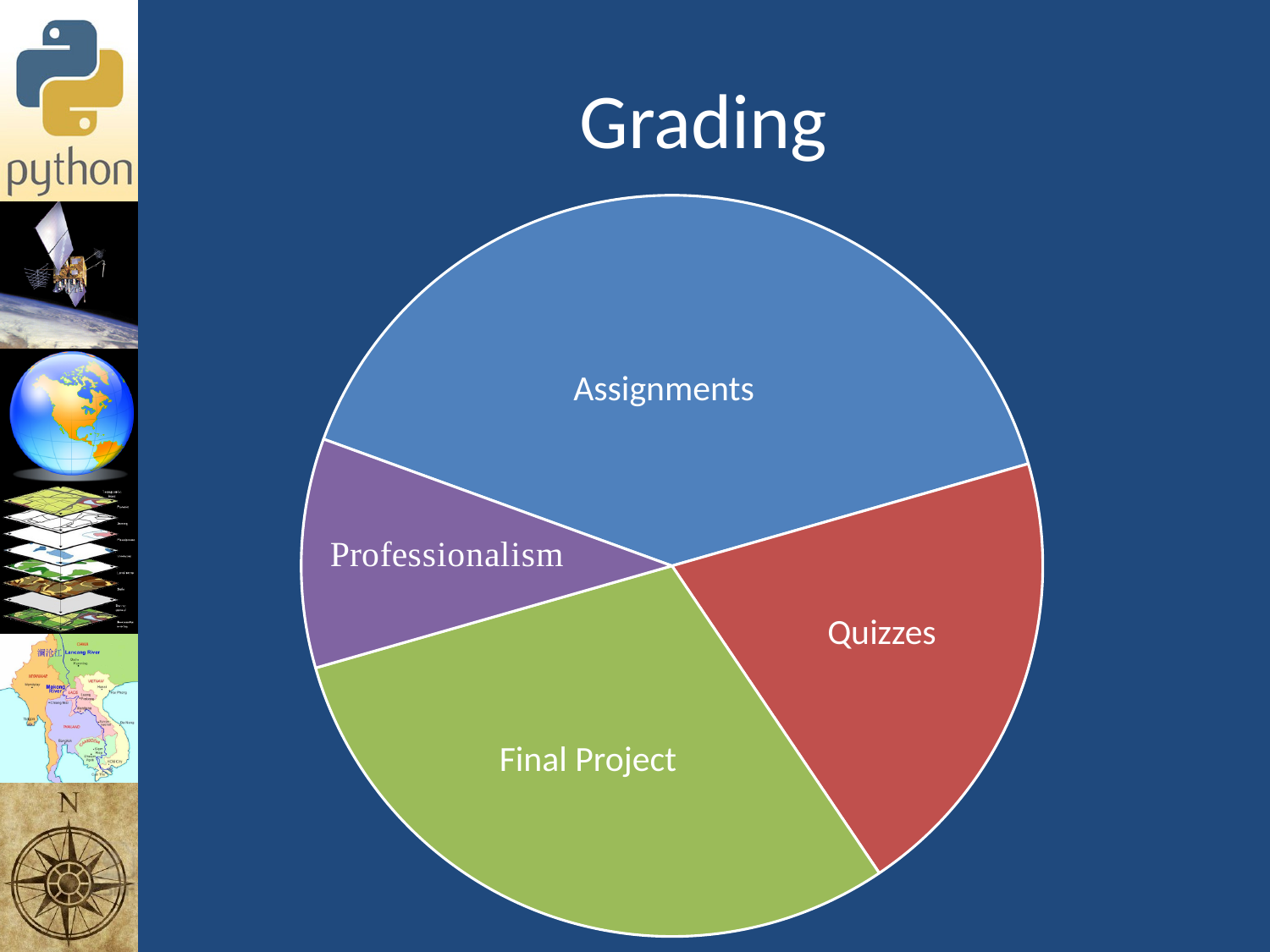
Which slice is larger, Final Project or Professionalism? Final Project Which slice is larger, Final Project or Quizzes? Final Project Which category has the second-largest slice of the pie chart? Final Project What colour is the Final Project slice of the pie chart? green Which slice is larger, Quizzes or Professionalism? Quizzes Which category has the largest slice of the pie chart? Assignments What kind of chart is shown on the slide? pie chart What is the title of the slide containing the pie chart? Grading Which category has the smallest slice of the pie chart? Professionalism How many slices does the pie chart have? 4